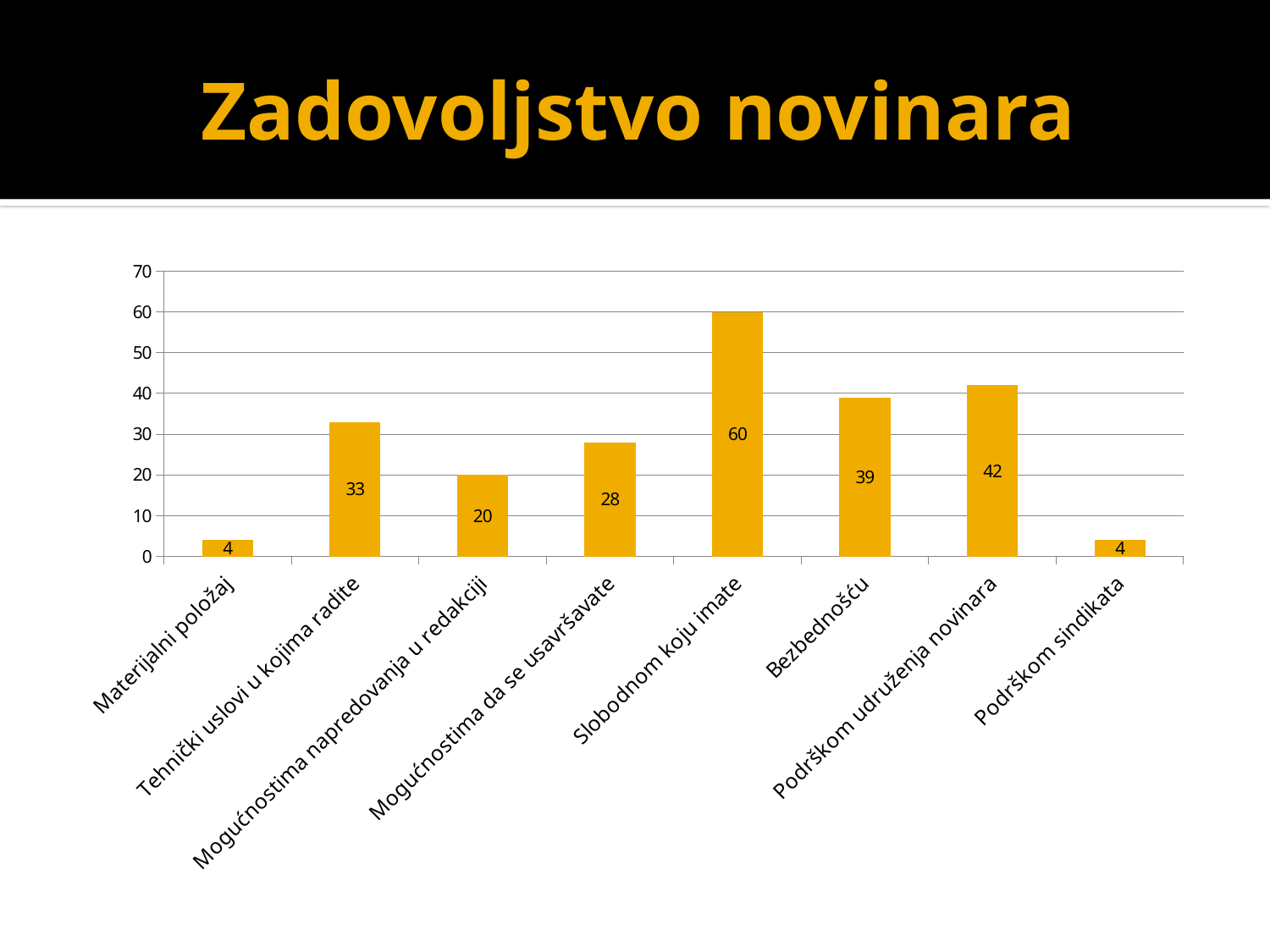
What is the difference between the values for Podrškom udruženja novinara and Bezbednošću? 3 How many categories are shown on the x axis? 8 What is the value for Tehnički uslovi u kojima radite? 33 What is the difference between the values for Slobodnom koju imate and Mogućnostima da se usavršavate? 32 What kind of chart is shown on the slide? bar chart Is the value for Podrškom udruženja novinara greater or less than 40? greater Which category has the highest value? Slobodnom koju imate What is the title of the slide? Zadovoljstvo novinara What is the value for Mogućnostima napredovanja u redakciji? 20 Which is larger, the value for Tehnički uslovi u kojima radite or the value for Mogućnostima da se usavršavate? Tehnički uslovi u kojima radite What is the value for Bezbednošću? 39 What is the value for Slobodnom koju imate? 60